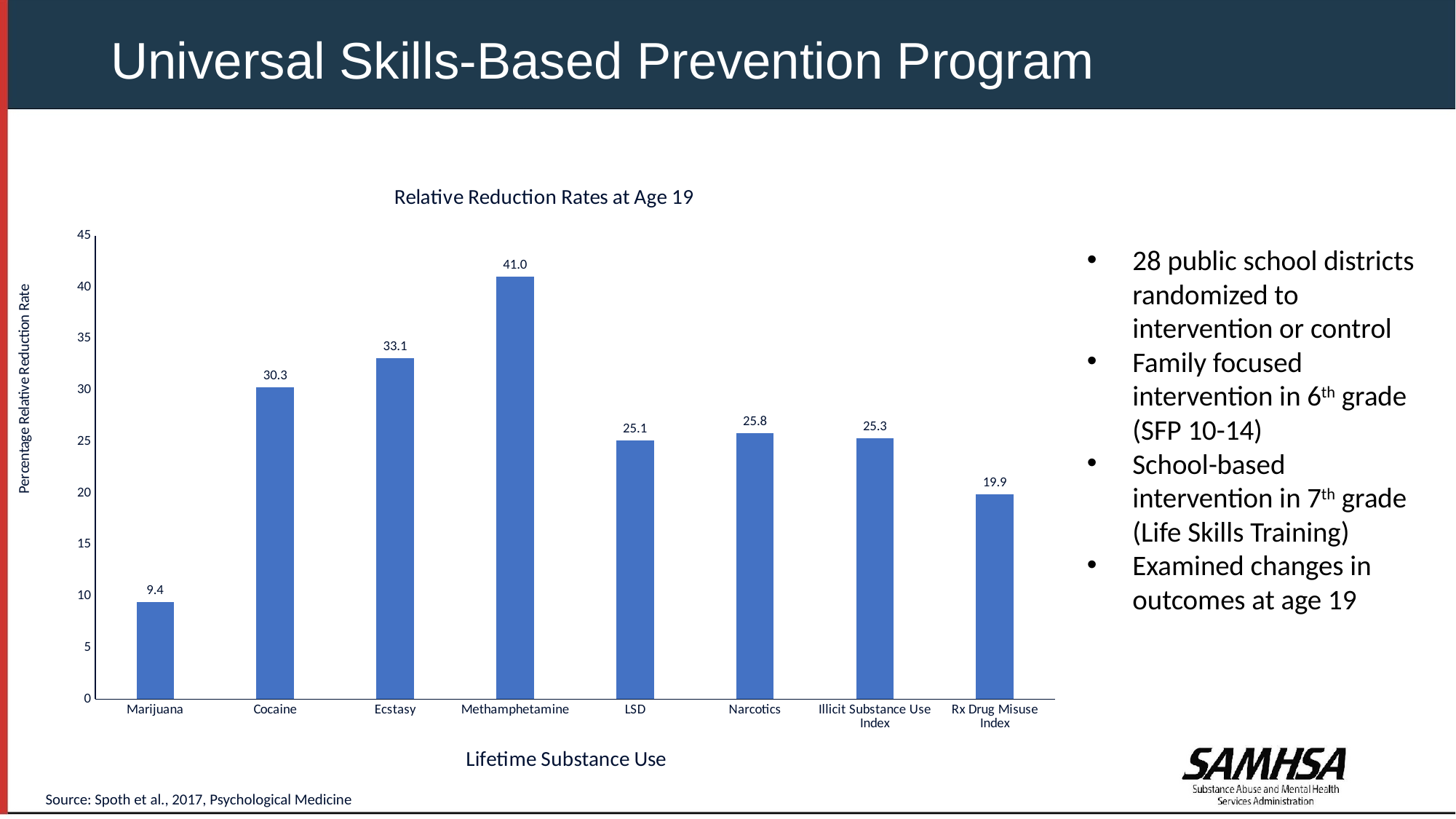
Which substance has the highest relative reduction rate? Methamphetamine Which category has the lowest relative reduction rate? Marijuana What is the relative reduction rate for Methamphetamine? 41.0 How many substance categories are shown on the x axis? 8 What type of chart is shown on the slide? Bar chart What is the value shown for the Rx Drug Misuse Index? 19.9 What is the difference between the values for Methamphetamine and Marijuana? 31.6 What is the relative reduction rate for Marijuana? 9.4 What is the title of the chart? Relative Reduction Rates at Age 19 Which has a higher relative reduction rate, Cocaine or LSD? Cocaine Is the value for Narcotics greater or less than 20? greater What is the difference between the values for Ecstasy and Cocaine? 2.8